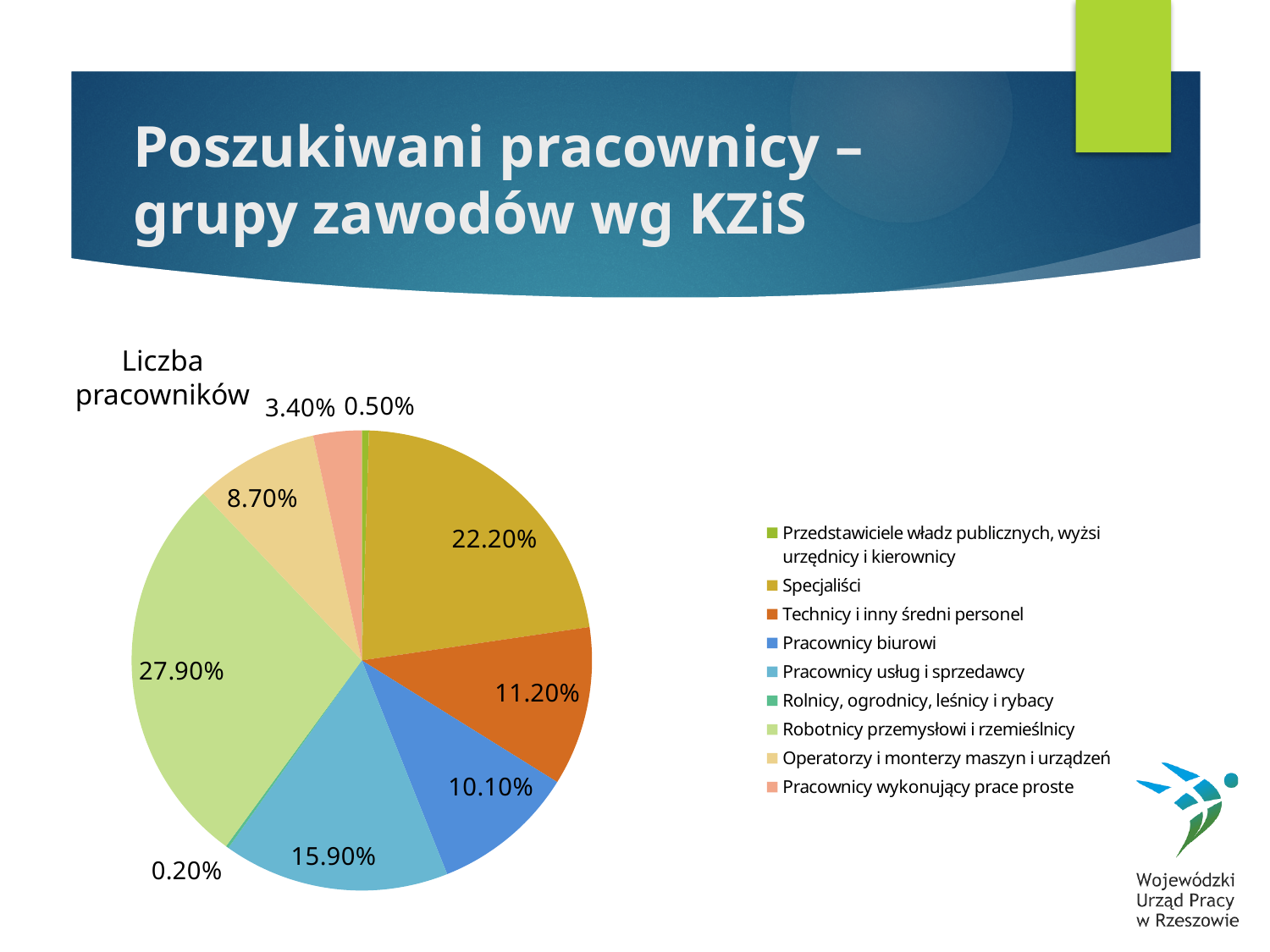
Which category has the largest share of the pie? Robotnicy przemysłowi i rzemieślnicy Which is larger, the share for Pracownicy biurowi or the share for Pracownicy usług i sprzedawcy? Pracownicy usług i sprzedawcy How many categories does the legend list? 9 Which category has the smallest share of the pie? Rolnicy, ogrodnicy, leśnicy i rybacy What is the title of the chart? Liczba pracowników What is the difference between the shares of Specjaliści and Technicy i inny średni personel? 11.00% What kind of chart is shown on the slide? pie chart What share of the pie does Pracownicy usług i sprzedawcy have? 15.90% What share of the pie does Pracownicy wykonujący prace proste have? 3.40% What share of the pie does Robotnicy przemysłowi i rzemieślnicy have? 27.90% What share of the pie does Specjaliści have? 22.20% What share of the pie does Operatorzy i monterzy maszyn i urządzeń have? 8.70%